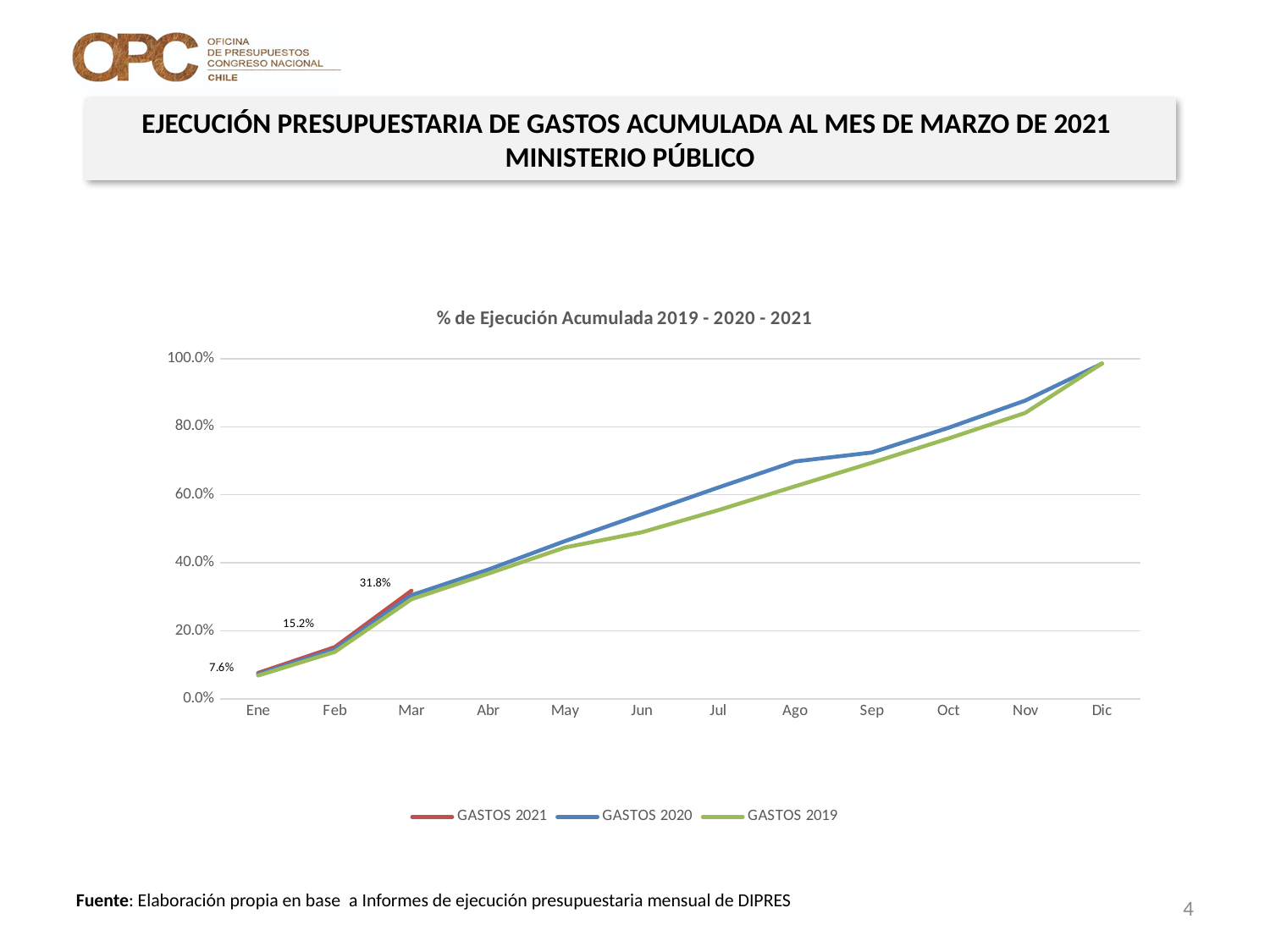
What is the difference between the GASTOS 2021 values for Mar and Feb? 16.6% Do the values for GASTOS 2020 rise or fall from Ene to Dic? Rise What kind of chart is shown on the slide? Line chart Is the value for GASTOS 2020 in Ago greater or less than 60.0%? greater What is the difference between the GASTOS 2021 values for Feb and Ene? 7.6% What is the value for GASTOS 2021 in Mar? 31.8% What is the value for GASTOS 2021 in Ene? 7.6% How many months are shown on the x axis? 12 In Ago, which series has the larger value, GASTOS 2020 or GASTOS 2019? GASTOS 2020 How many series does the legend list? 3 What is the value for GASTOS 2021 in Feb? 15.2% Is the value for GASTOS 2019 in Jun greater or less than 60.0%? less